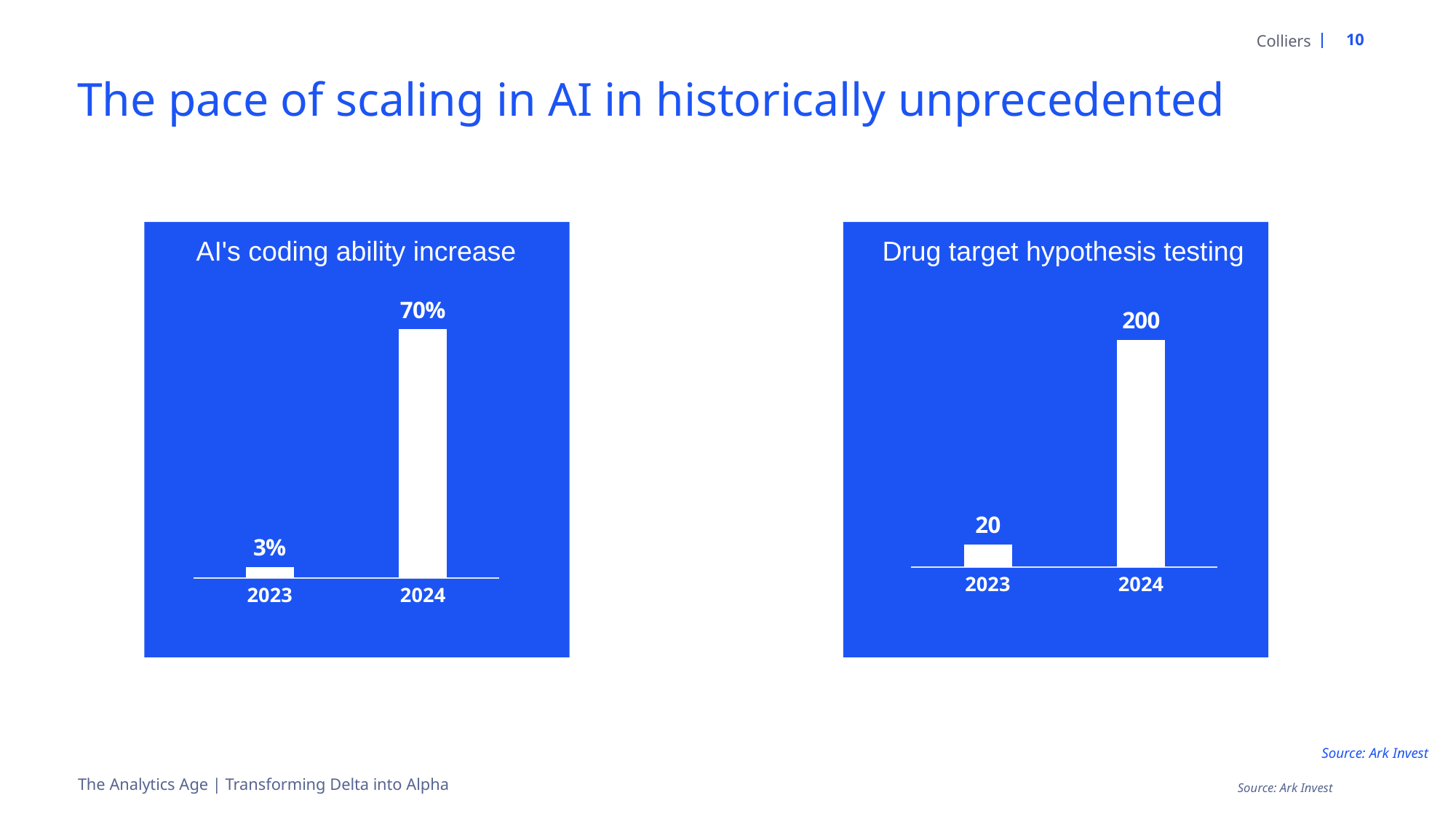
In the 'Drug target hypothesis testing' chart, which is larger, the value for 2023 or 2024? 2024 In the 'AI's coding ability increase' chart, what is the value for 2024? 70% In the 'Drug target hypothesis testing' chart, what is the value for 2023? 20 In the 'Drug target hypothesis testing' chart, what is the difference between the 2024 and 2023 values? 180 What kind of chart is the 'Drug target hypothesis testing' chart? Bar chart In the 'AI's coding ability increase' chart, do the values rise or fall from 2023 to 2024? Rise In the 'Drug target hypothesis testing' chart, what is the value for 2024? 200 In the 'Drug target hypothesis testing' chart, which year has the lowest value? 2023 In the 'AI's coding ability increase' chart, what is the difference between the 2024 and 2023 values? 67% In the 'AI's coding ability increase' chart, what is the value for 2023? 3% In the 'AI's coding ability increase' chart, which year has the highest value? 2024 How many categories are shown in the 'AI's coding ability increase' chart? 2